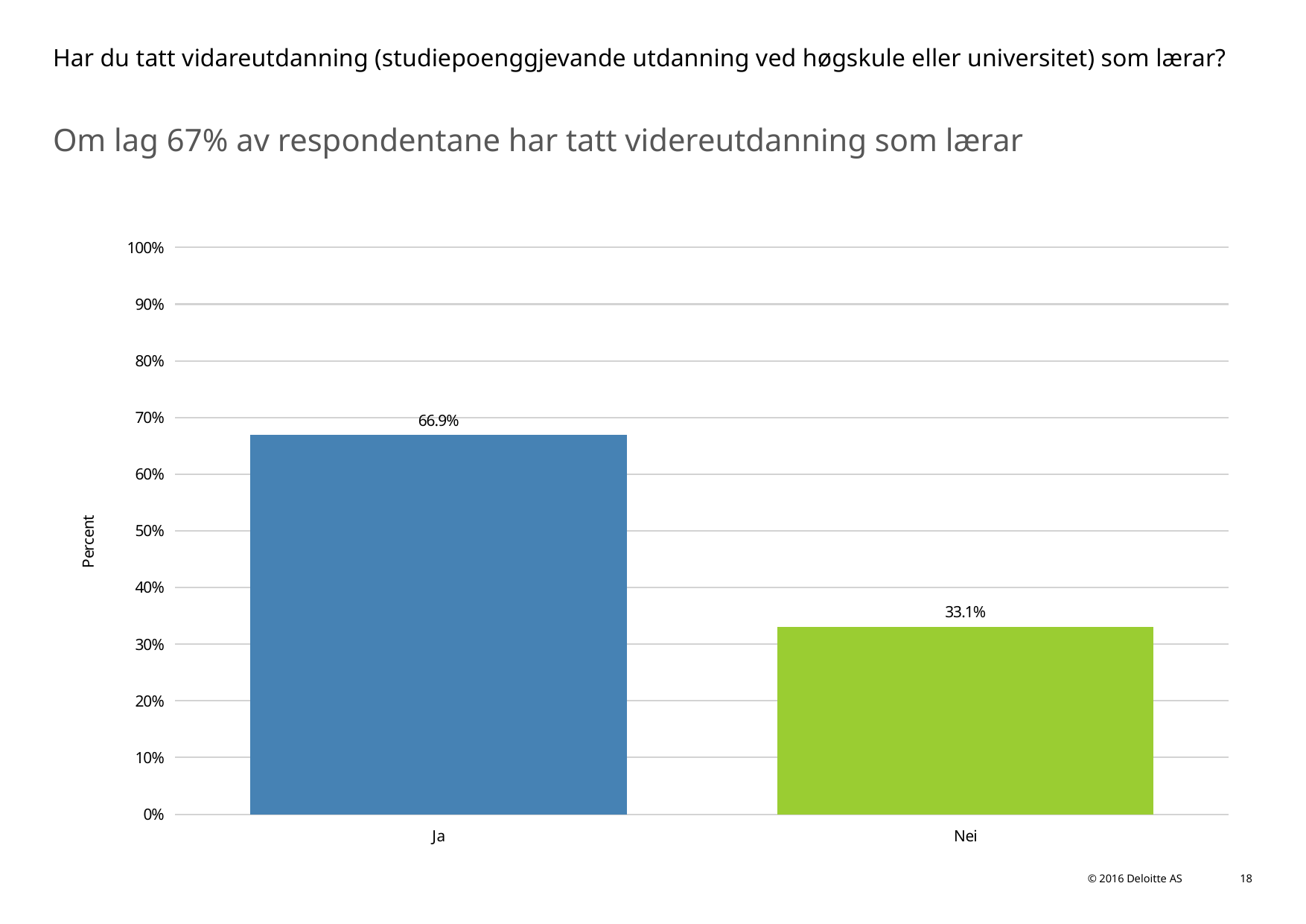
Is the value for Ja greater or less than 60%? greater Is the value for Nei greater or less than 40%? less What is the difference between the values for Ja and Nei? 33.8% Which is larger, the value for Ja or the value for Nei? Ja What is the value for Nei? 33.1% Which category has the highest value? Ja How many categories are shown on the x axis? 2 What is the label of the y axis? Percent What kind of chart is shown on the slide? bar chart What is the value for Ja? 66.9% Which category has the lowest value? Nei What colour is the bar for Nei? green